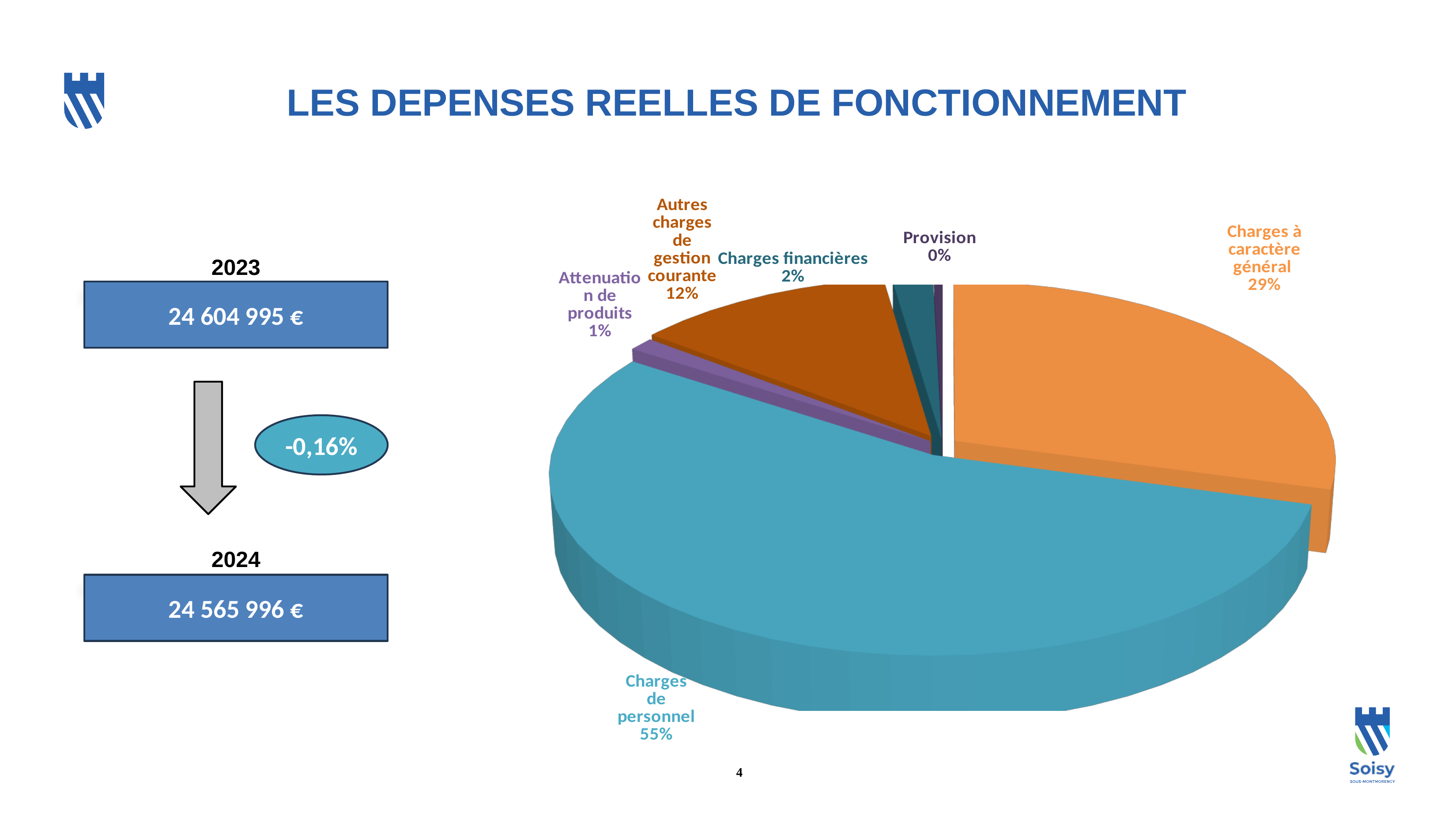
What is the value shown for Autres charges de gestion courante? 12% How many categories are shown in the pie chart? 6 What is the value shown for Attenuation de produits? 1% Which category has the smallest share of the pie? Provision Which category has the largest share of the pie? Charges de personnel What is the value shown for Provision? 0% What kind of chart is shown on the slide? Pie chart What is the difference in percentage points between Charges de personnel and Charges à caractère général? 26 What is the value shown for Charges financières? 2% What share of the pie does Charges à caractère général represent? 29% What share of the pie does Charges de personnel represent? 55% Which is larger, Autres charges de gestion courante or Charges financières? Autres charges de gestion courante